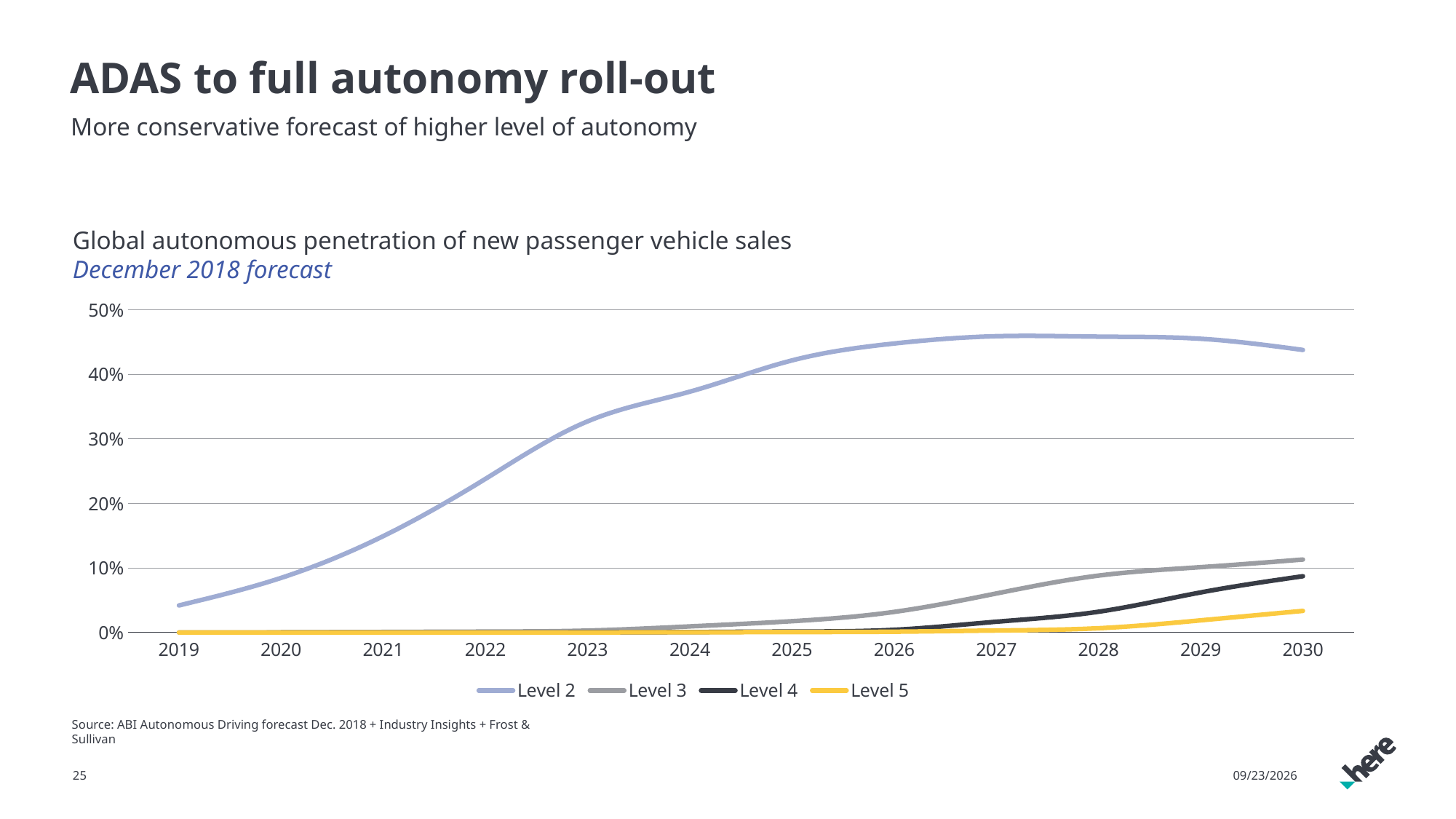
Is the value for Level 2 in 2022 greater or less than 20%? greater What is the title of the chart? Global autonomous penetration of new passenger vehicle sales Does the Level 3 line rise or fall from 2019 to 2030? rise How many years are shown on the x axis? 12 How many series does the legend list? 4 Which series has the lowest value in 2030? Level 5 What kind of chart is shown on the slide? line chart Is the value for Level 2 in 2027 greater or less than 40%? greater In 2030, which is larger: Level 3 or Level 4? Level 3 Which series has the highest value in 2030? Level 2 Is the value for Level 2 in 2019 greater or less than 10%? less